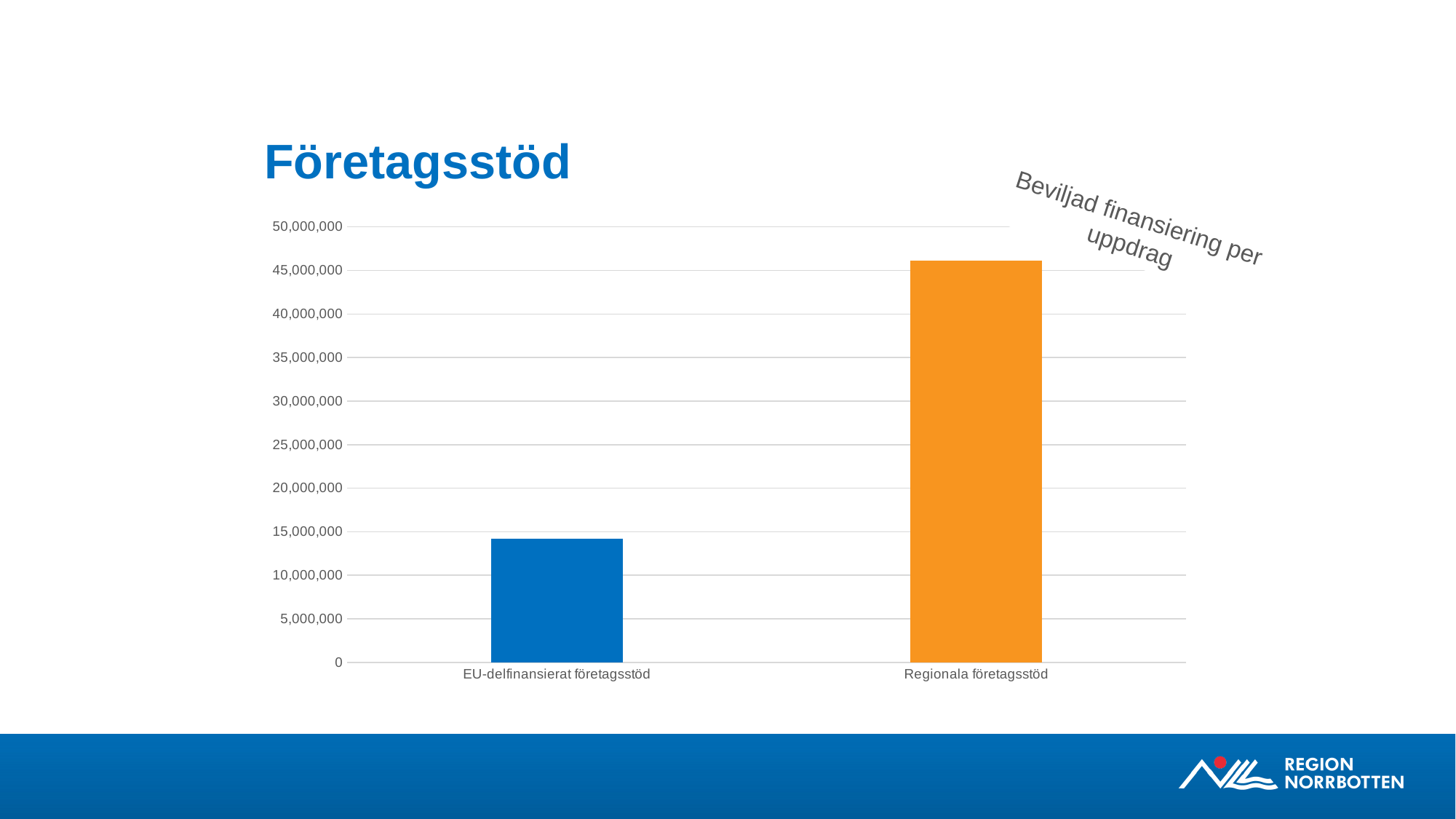
What colour is the bar for Regionala företagsstöd? orange What kind of chart is shown on the slide? bar chart Which category has the highest value? Regionala företagsstöd Which category has the lowest value? EU-delfinansierat företagsstöd Is the value for Regionala företagsstöd greater or less than 45,000,000? greater How many categories are plotted in the chart? 2 Is the value for Regionala företagsstöd greater or less than 50,000,000? less Which is larger, the value for EU-delfinansierat företagsstöd or the value for Regionala företagsstöd? Regionala företagsstöd Is the value for EU-delfinansierat företagsstöd greater or less than 15,000,000? less Do the values rise or fall from left to right along the x axis? rise